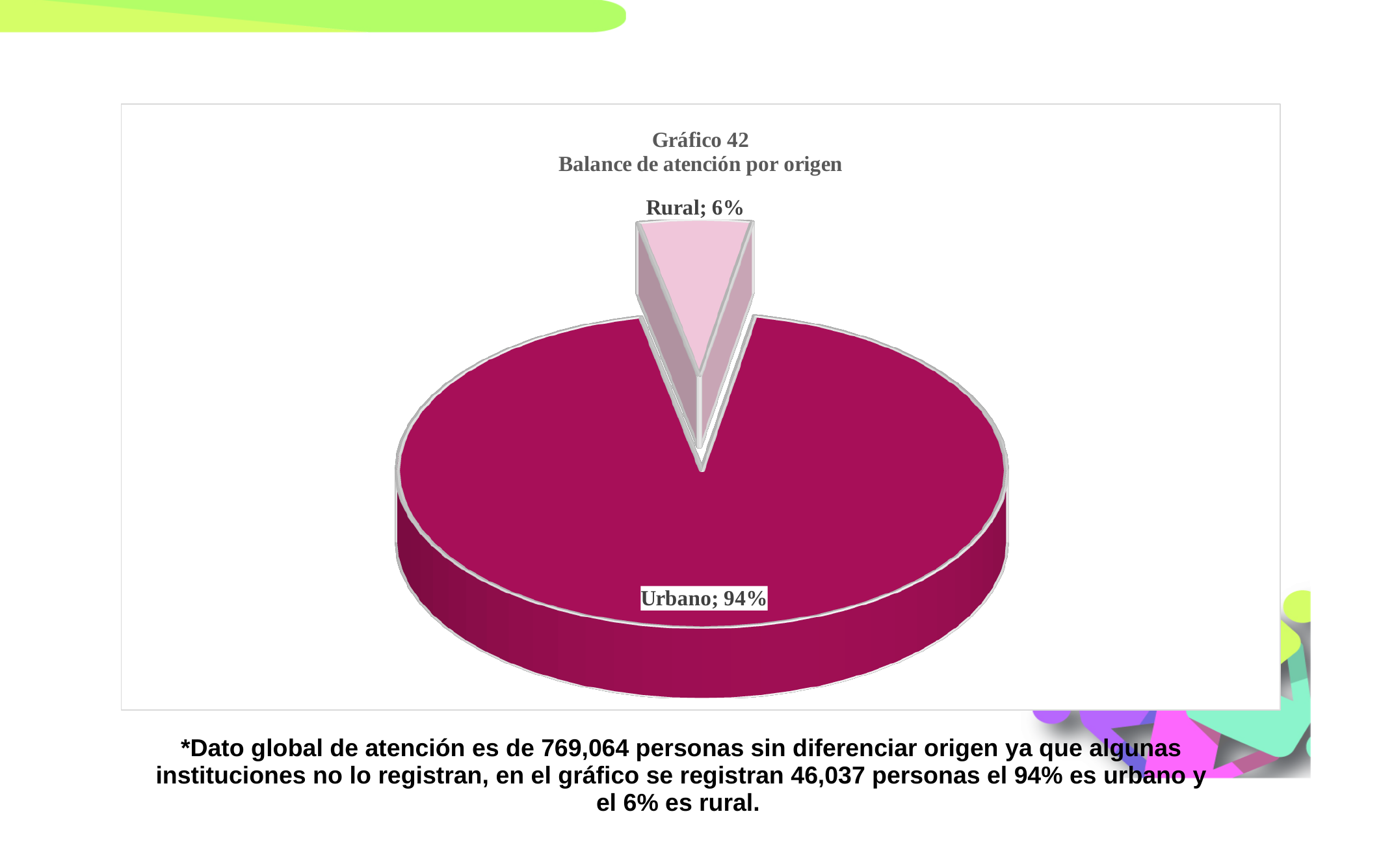
What share of the pie does Urbano represent? 94% Which category has the largest slice of the pie? Urbano Which category has the smallest slice of the pie? Rural What is the title of the chart? Gráfico 42 Balance de atención por origen Which is larger, the Urbano slice or the Rural slice? Urbano What kind of chart is shown on the slide? Pie chart What share of the pie does Rural represent? 6% Which slice is shown in the lighter pink colour? Rural What is the difference in percentage points between the Urbano and Rural slices? 88 How many categories are shown in the pie chart? 2